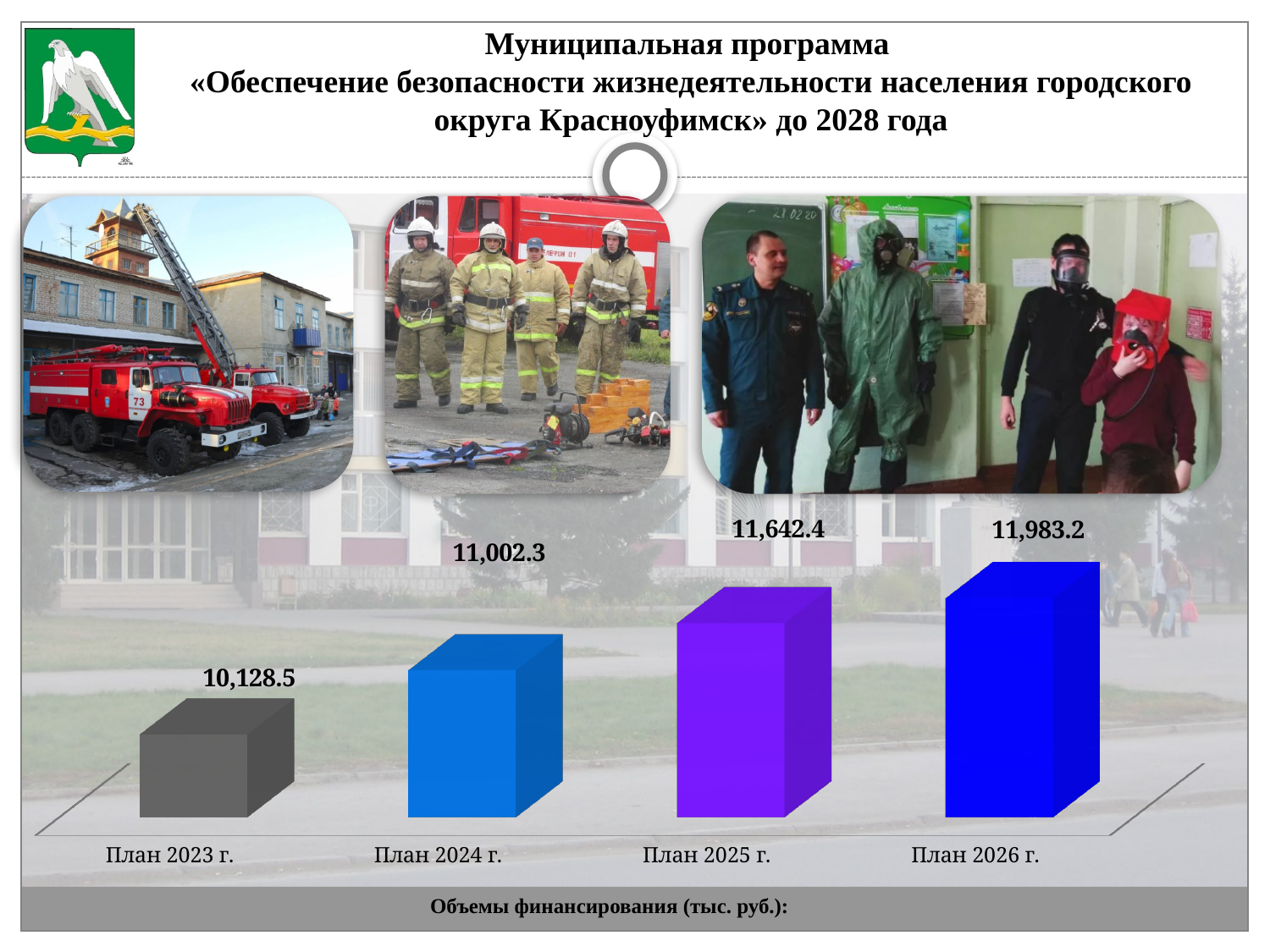
What is the value for План 2023 г.? 10,128.5 What kind of chart is shown on the slide? Bar chart What is the value for План 2024 г.? 11,002.3 What is the value for План 2025 г.? 11,642.4 What is the difference between the values for План 2026 г. and План 2023 г.? 1,854.7 What is the difference between the values for План 2024 г. and План 2023 г.? 873.8 What is the value for План 2026 г.? 11,983.2 Do the values rise or fall from План 2023 г. to План 2026 г.? Rise Which category has the highest value? План 2026 г. Which category has the lowest value? План 2023 г. Which is larger, the value for План 2025 г. or the value for План 2024 г.? План 2025 г. How many categories are shown in the chart? 4